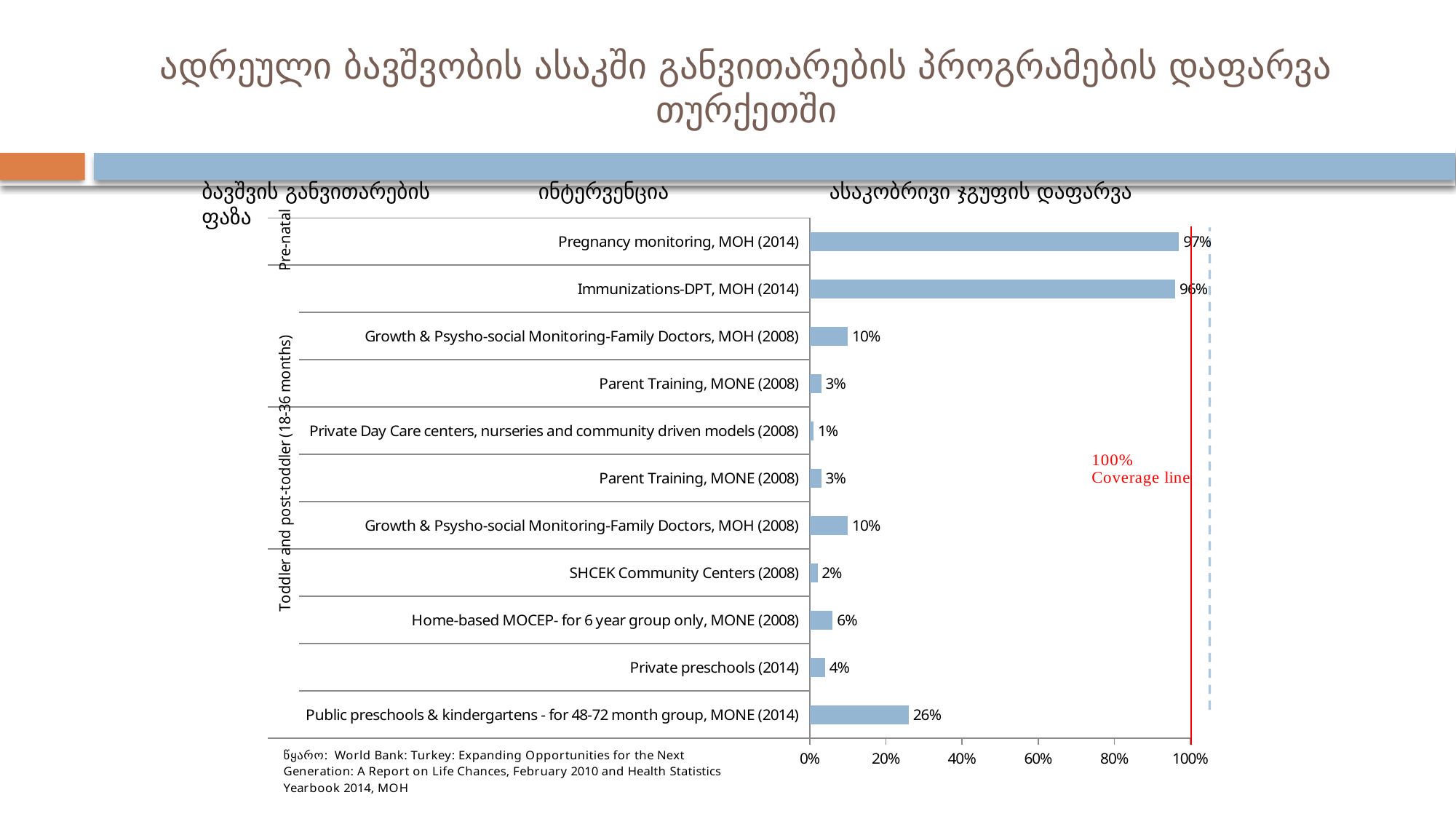
Which has higher coverage: Private preschools (2014) or SHCEK Community Centers (2008)? Private preschools (2014) What does the red vertical line in the chart represent? 100% Coverage line What is the coverage value for Public preschools & kindergartens - for 48-72 month group, MONE (2014)? 26% What is the difference in coverage between Pregnancy monitoring, MOH (2014) and Immunizations-DPT, MOH (2014)? 1% Which intervention has the highest coverage? Pregnancy monitoring, MOH (2014) Is the coverage for Public preschools & kindergartens - for 48-72 month group, MONE (2014) greater or less than 40%? less What type of chart is shown on the slide? bar chart What is the coverage value for Home-based MOCEP- for 6 year group only, MONE (2008)? 6% Which intervention has the lowest coverage? Private Day Care centers, nurseries and community driven models (2008) What is the coverage value for Pregnancy monitoring, MOH (2014)? 97% How many interventions (bars) are shown in the chart? 11 What is the coverage value for Immunizations-DPT, MOH (2014)? 96%